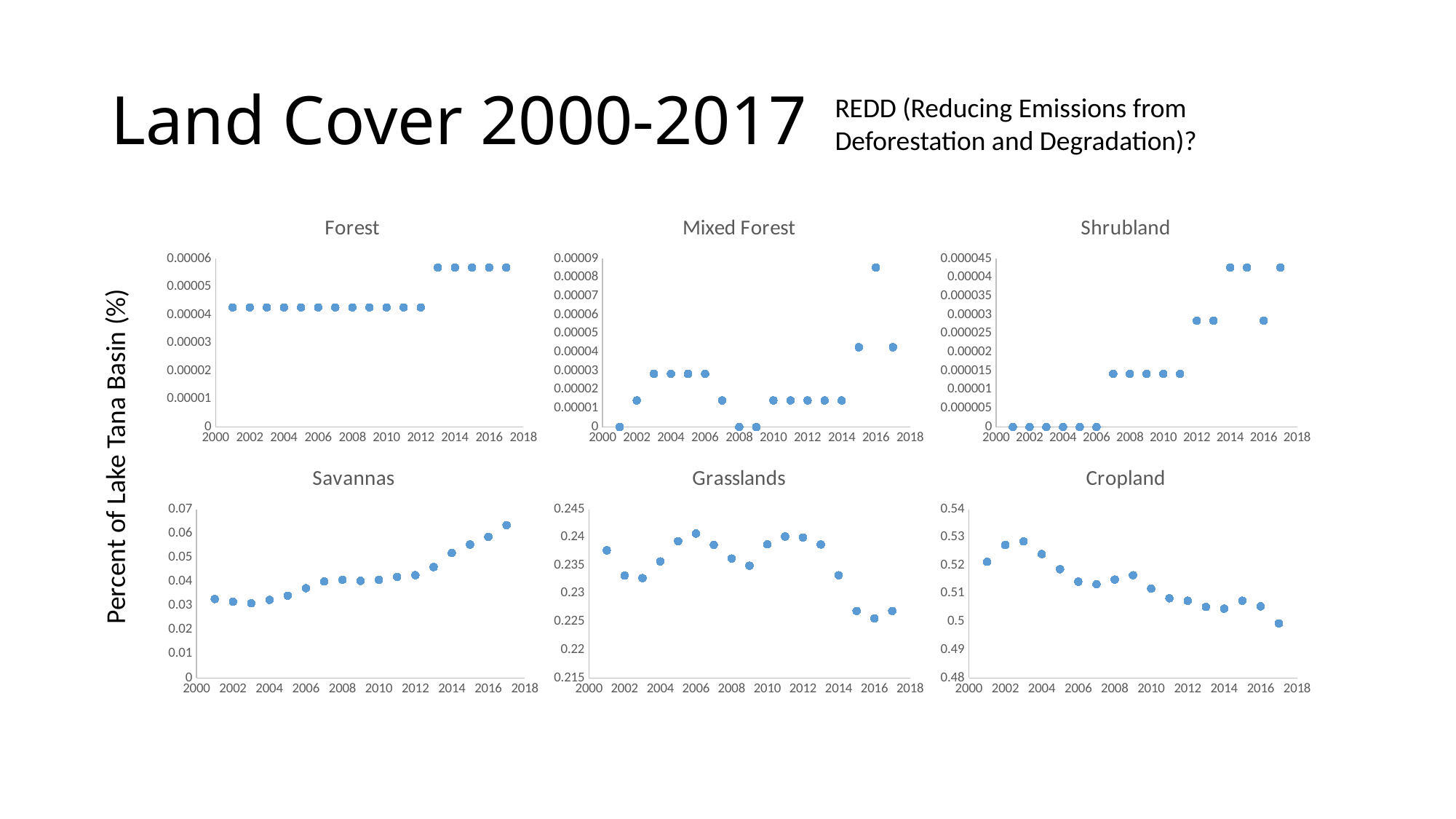
In the Savannas chart, which year has the highest value? 2017 In the Mixed Forest chart, what is the value for 2001? 0 How many charts are shown on the slide? 6 In the Savannas chart, do the values generally rise or fall from 2003 to 2017? rise In the Cropland chart, do the values generally rise or fall from 2003 to 2017? fall In the Mixed Forest chart, which year has the highest value? 2016 In the Shrubland chart, what is the value for 2003? 0 In the Forest chart, is the value for 2015 greater or less than 0.00005? greater In the Cropland chart, which year has the lowest value? 2017 In the Grasslands chart, which year has the lowest value? 2016 In the Savannas chart, is the value for 2017 greater or less than 0.06? greater